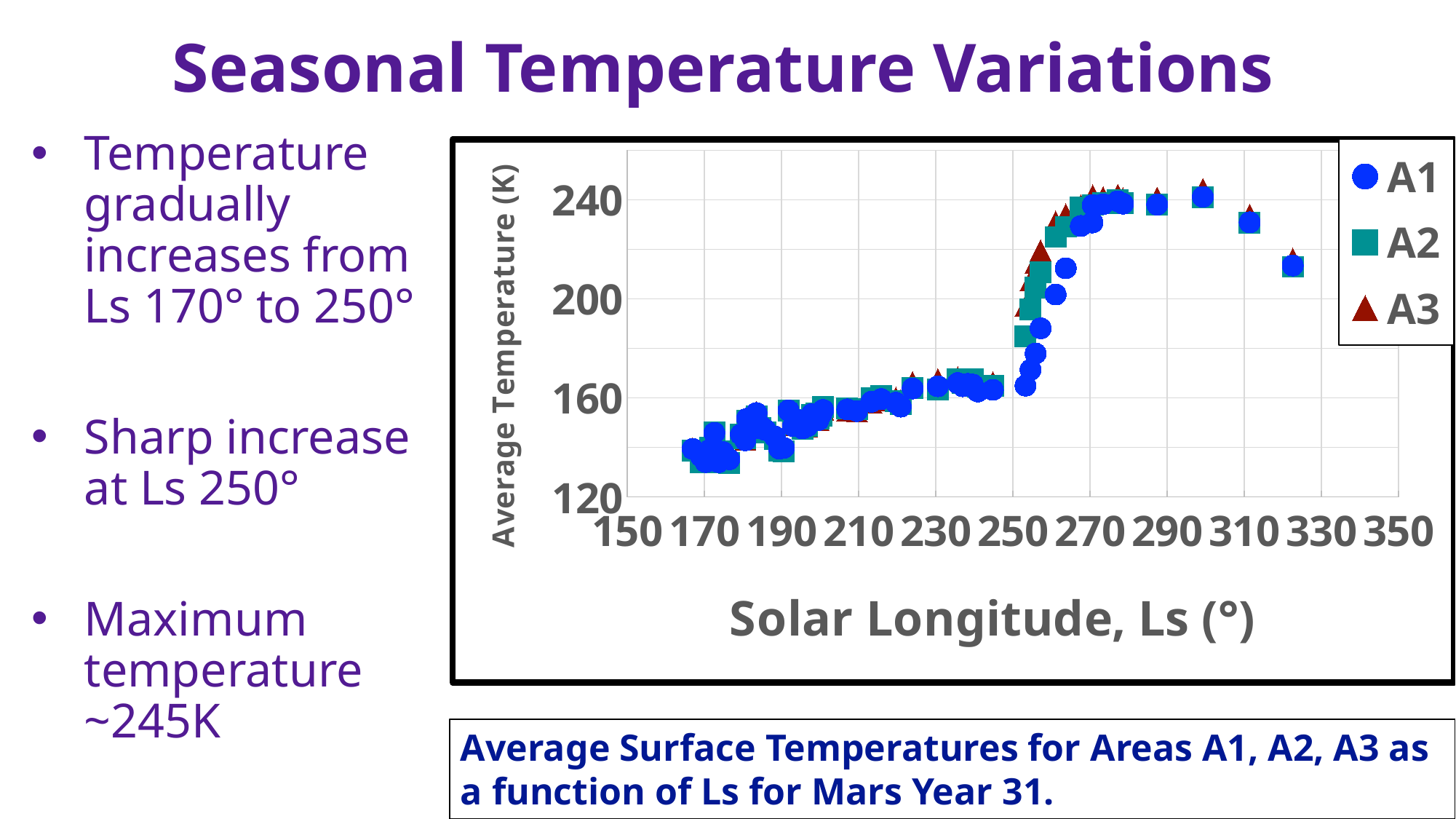
Is the average temperature at Ls 250° greater or less than 200 K? less What kind of chart is shown on the slide? scatter chart Is the average temperature at Ls 270° greater or less than 200 K? greater Do the plotted temperatures rise or fall as Ls increases from 170° to 250°? rise What is the label of the chart's x axis? Solar Longitude, Ls (°) What are the names of the series listed in the chart legend? A1, A2, A3 Is the temperature at Ls 290° greater or less than the temperature at Ls 170°? greater Do the plotted temperatures rise or fall as Ls increases from 290° to 330°? fall Is the average temperature at Ls 290° greater or less than 200 K? greater How many series does the chart legend list? 3